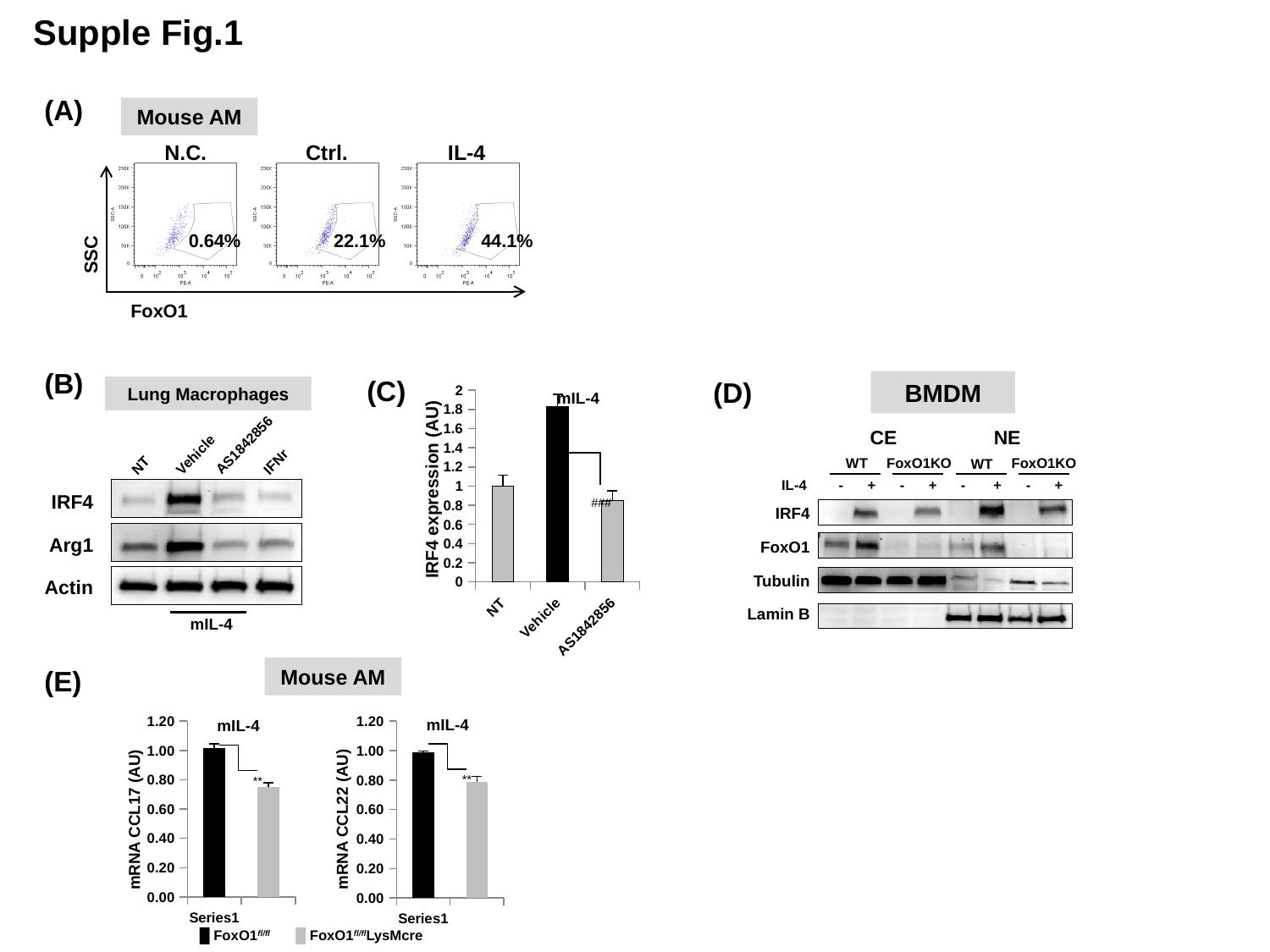
In the panel (C) IRF4 expression chart, which category has the lowest bar? AS1842856 In the panel (E) mRNA CCL22 chart, is the value for FoxO1fl/flLysMcre greater or less than 0.60? greater In the panel (C) IRF4 expression chart, which category has the highest bar? Vehicle What kind of chart is used in panel (C)? bar chart In the panel (C) IRF4 expression chart, how many categories are shown on the x axis? 3 In panel (A), what percentage is printed in the N.C. flow cytometry plot? 0.64% In panel (A), what percentage is printed in the IL-4 flow cytometry plot? 44.1% In the panel (E) mRNA CCL17 chart, which series has the larger bar, FoxO1fl/fl or FoxO1fl/flLysMcre? FoxO1fl/fl In panel (A), what percentage is printed in the Ctrl. flow cytometry plot? 22.1% In panel (A), which of the three plots (N.C., Ctrl., IL-4) shows the highest printed percentage? IL-4 In panel (A), what is the difference between the percentages printed for IL-4 and Ctrl.? 22.0% In the panel (C) IRF4 expression chart, is the value for Vehicle greater or less than 1.6? greater